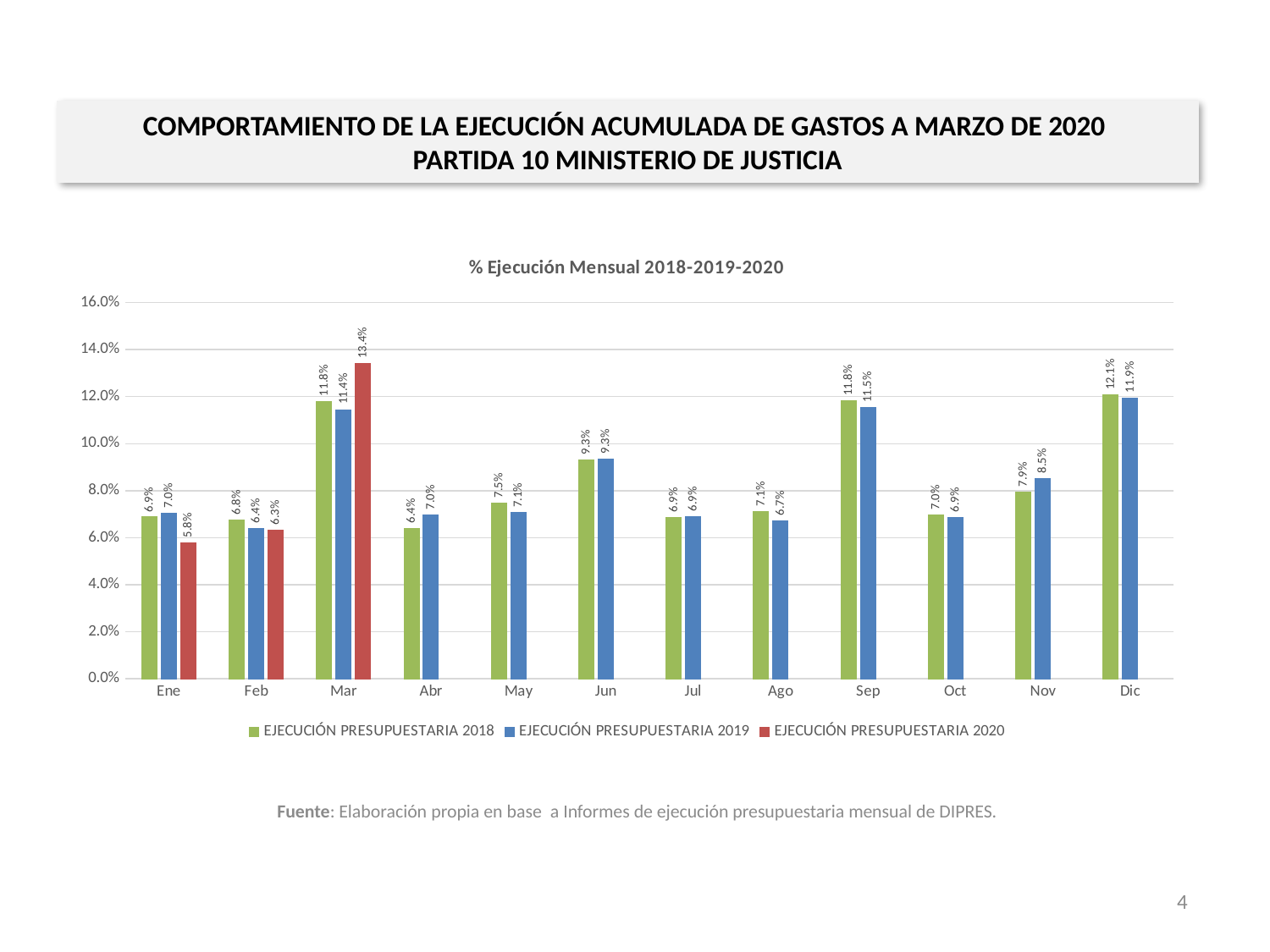
In Abr, which is larger: EJECUCIÓN PRESUPUESTARIA 2018 or EJECUCIÓN PRESUPUESTARIA 2019? EJECUCIÓN PRESUPUESTARIA 2019 Is the value for EJECUCIÓN PRESUPUESTARIA 2018 in Sep greater or less than 10.0%? greater How many months are shown on the x axis? 12 What is the value for EJECUCIÓN PRESUPUESTARIA 2020 in Mar? 13.4% What is the value for EJECUCIÓN PRESUPUESTARIA 2020 in Ene? 5.8% Which month has the highest value for EJECUCIÓN PRESUPUESTARIA 2018? Dic Which month has the lowest value for EJECUCIÓN PRESUPUESTARIA 2019? Feb How many series does the legend list? 3 What is the value for EJECUCIÓN PRESUPUESTARIA 2019 in Nov? 8.5% What type of chart is shown on the slide? Bar chart What is the difference between the EJECUCIÓN PRESUPUESTARIA 2020 and EJECUCIÓN PRESUPUESTARIA 2019 values in Mar? 2.0% What is the value for EJECUCIÓN PRESUPUESTARIA 2018 in Dic? 12.1%